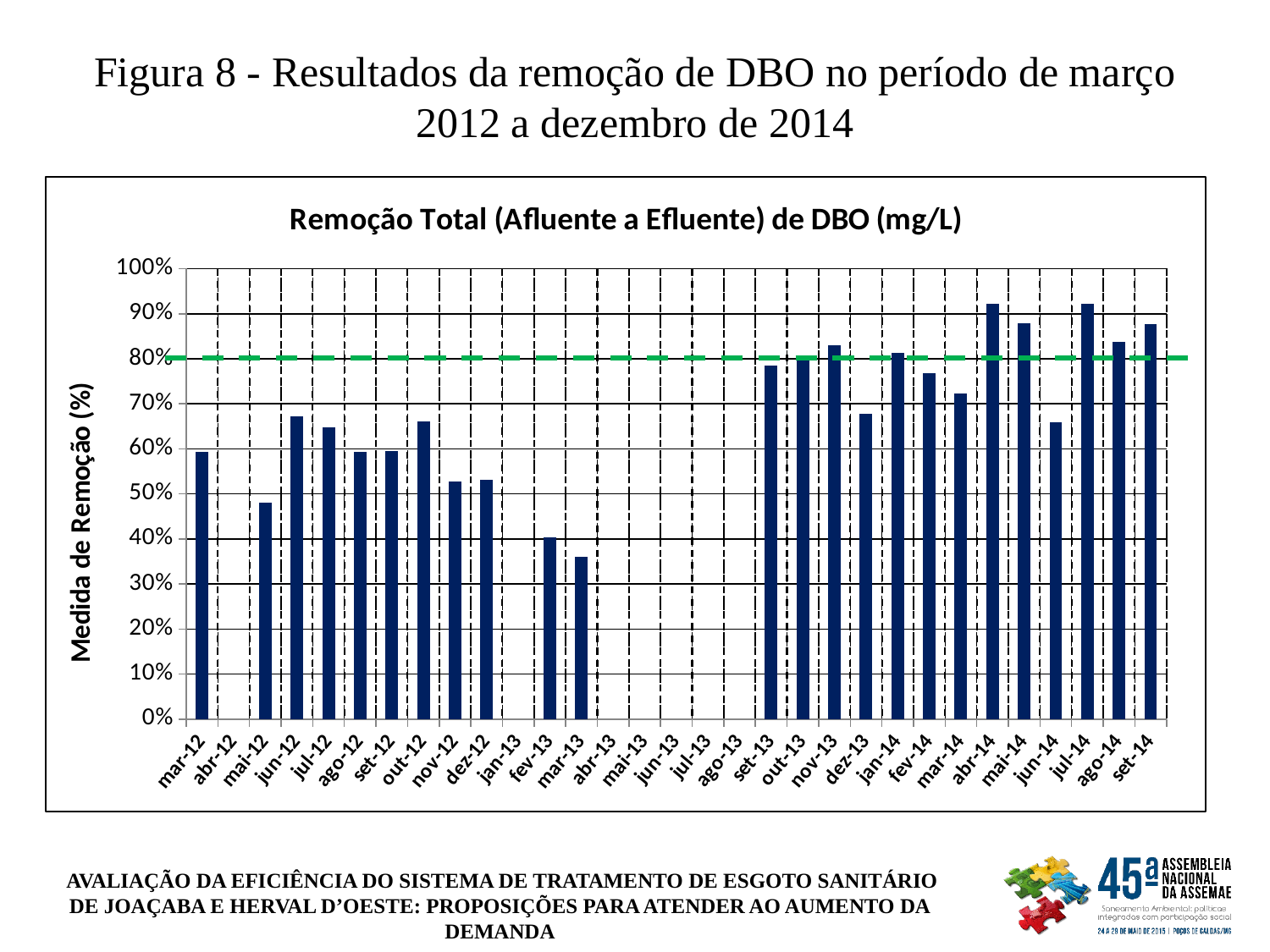
Which is larger, the value for abr-14 or the value for jun-14? abr-14 What is the title of the chart? Remoção Total (Afluente a Efluente) de DBO (mg/L) Is the value for abr-14 greater or less than 90%? greater Is the value for mar-13 greater or less than 40%? less Do the values rise or fall from set-13 to nov-13? rise Which is larger, the value for jun-12 or the value for mai-12? jun-12 What is the label of the vertical axis? Medida de Remoção (%) Is the value for set-13 greater or less than 80%? less What kind of chart is shown on the slide? bar chart Which month has the lowest removal value? mar-13